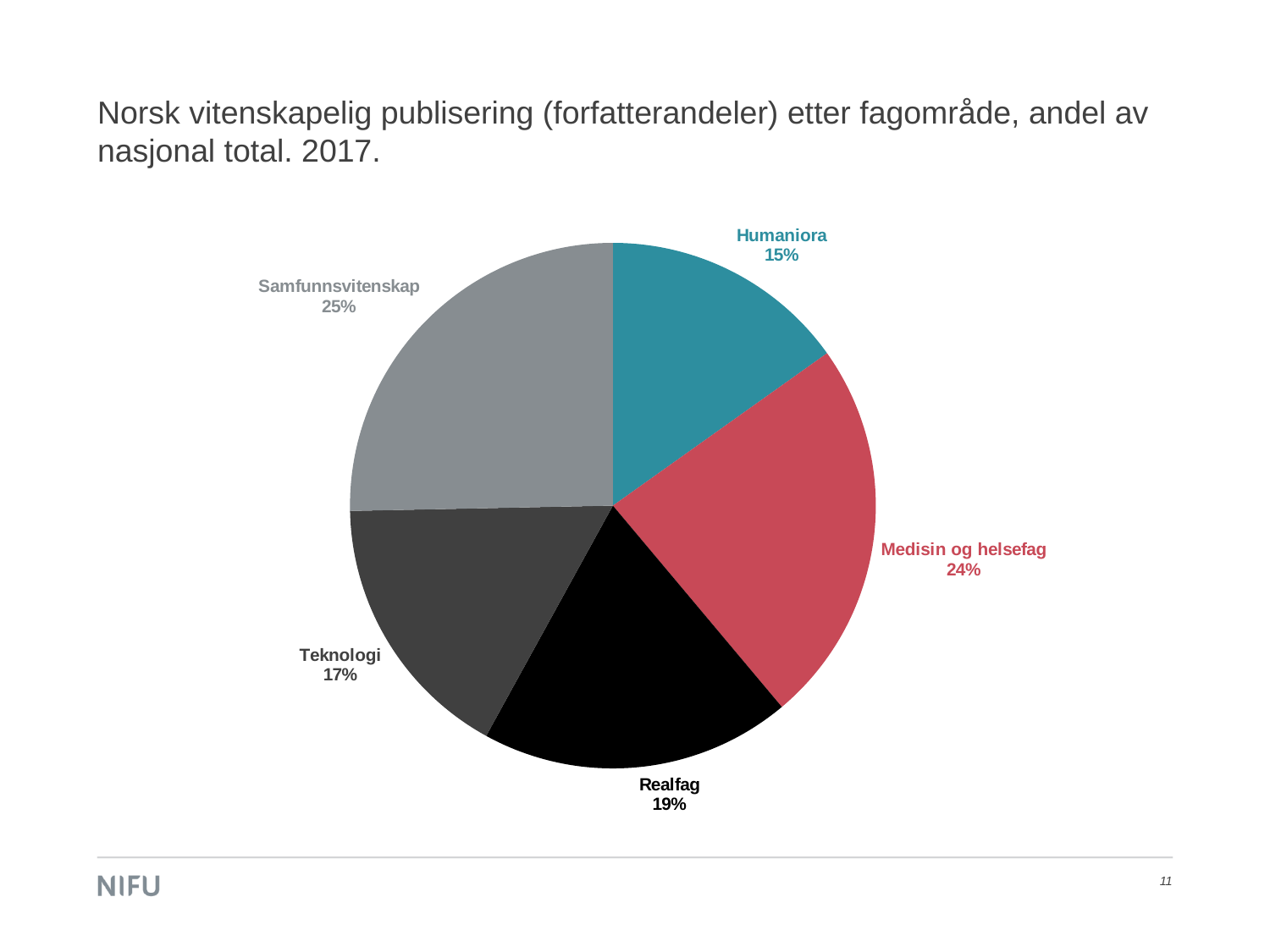
What is the difference in percentage points between Samfunnsvitenskap and Teknologi? 8 Which category has the smallest share of the pie? Humaniora Which category is shown in red on the pie chart? Medisin og helsefag What is the value shown for Teknologi? 17% Which category has the largest share of the pie? Samfunnsvitenskap What is the value shown for Medisin og helsefag? 24% How many categories are shown in the pie chart? 5 Which is larger, the share for Realfag or the share for Teknologi? Realfag What is the value shown for Samfunnsvitenskap? 25% What is the value shown for Realfag? 19% What share of the pie does Humaniora have? 15% What kind of chart is shown on the slide? pie chart